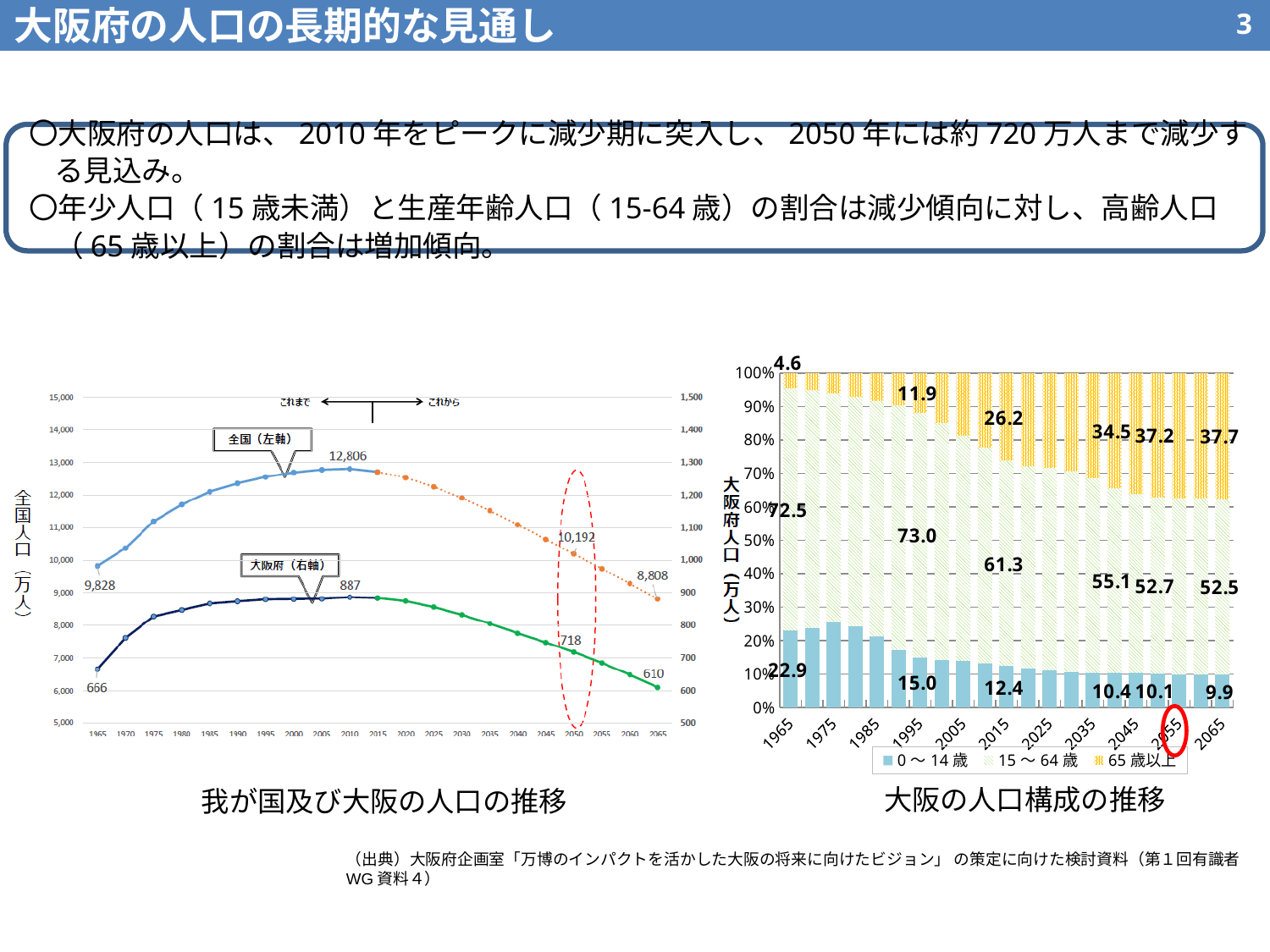
In the left chart (我が国及び大阪の人口の推移), what is the labelled peak value of the 全国 (national) population in 2010? 12,806 In the left chart (我が国及び大阪の人口の推移), what is the difference between the 全国 values labelled for 2010 and 2065? 3,998 In the right chart (大阪の人口構成の推移), does the share of 65歳以上 rise or fall from 1965 to 2065? rise In the left chart (我が国及び大阪の人口の推移), what is the labelled value for 全国 in 1965? 9,828 In the right chart (大阪の人口構成の推移), what is the labelled value for 65歳以上 in 1965? 4.6 In the right chart (大阪の人口構成の推移), what is the labelled value for 15～64歳 in 2065? 52.5 What kind of chart is the right chart titled 大阪の人口構成の推移? stacked bar chart In the left chart (我が国及び大阪の人口の推移), what is the labelled value for 大阪府 in 2065? 610 What kind of chart is the left chart titled 我が国及び大阪の人口の推移? line chart How many series does the legend of the right chart (大阪の人口構成の推移) list? 3 In the right chart (大阪の人口構成の推移), what is the difference between the 0～14歳 values labelled for 1965 and 2065? 13.0 In the left chart (我が国及び大阪の人口の推移), what is the labelled value for 大阪府 in 2010? 887